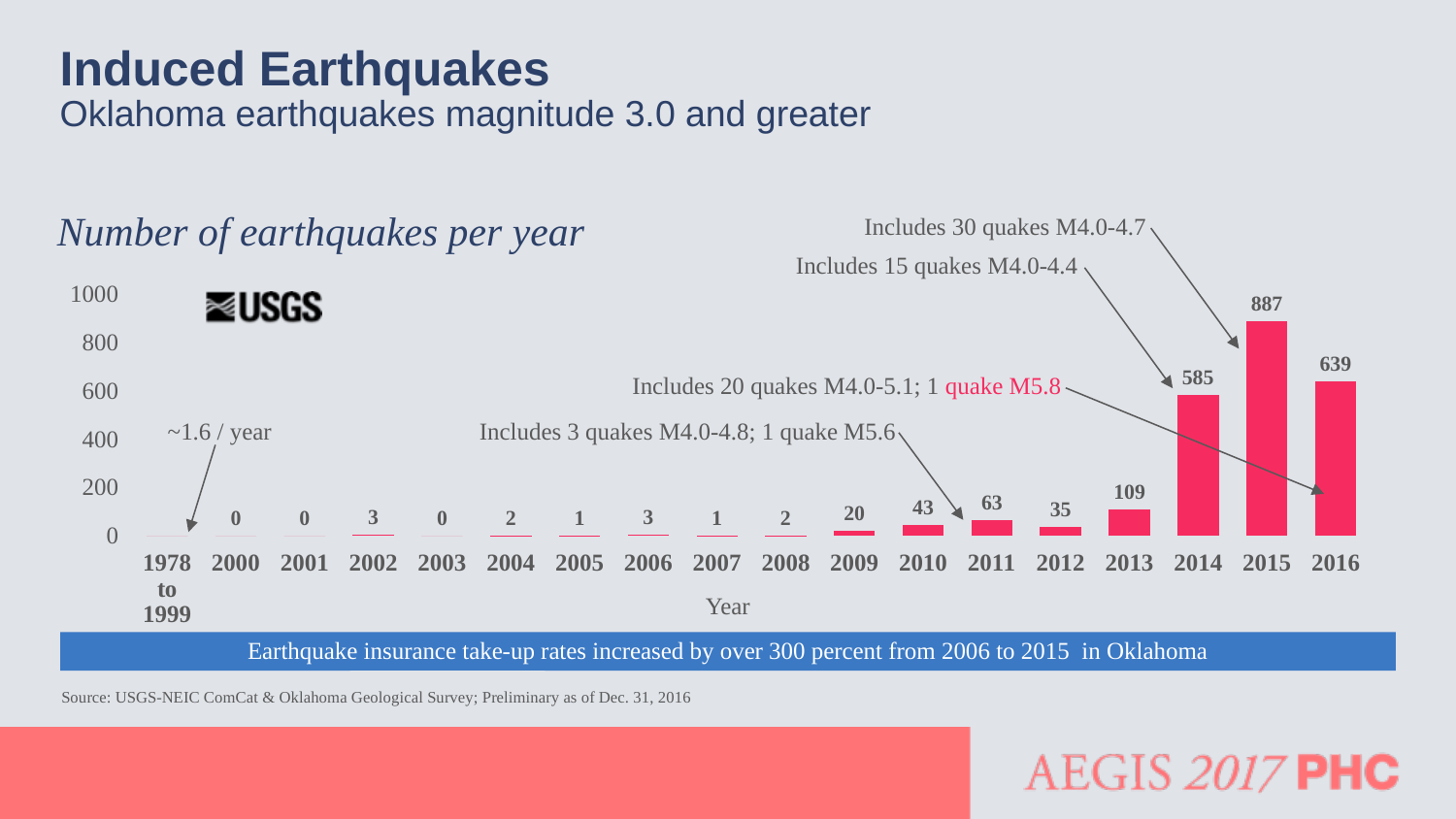
How many categories are shown on the x axis? 18 Is the value for 2014 greater or less than 400? greater Which year has the highest number of earthquakes? 2015 What is the number of earthquakes for 2013? 109 What is the title of the chart? Number of earthquakes per year Do the values generally rise or fall from 2009 to 2015? Rise What is the number of earthquakes for 2015? 887 What is the difference between the number of earthquakes in 2014 and 2013? 476 What is the number of earthquakes for 2009? 20 Which year has more earthquakes, 2011 or 2012? 2011 What kind of chart is shown on the slide? Bar chart What is the difference between the number of earthquakes in 2015 and 2016? 248